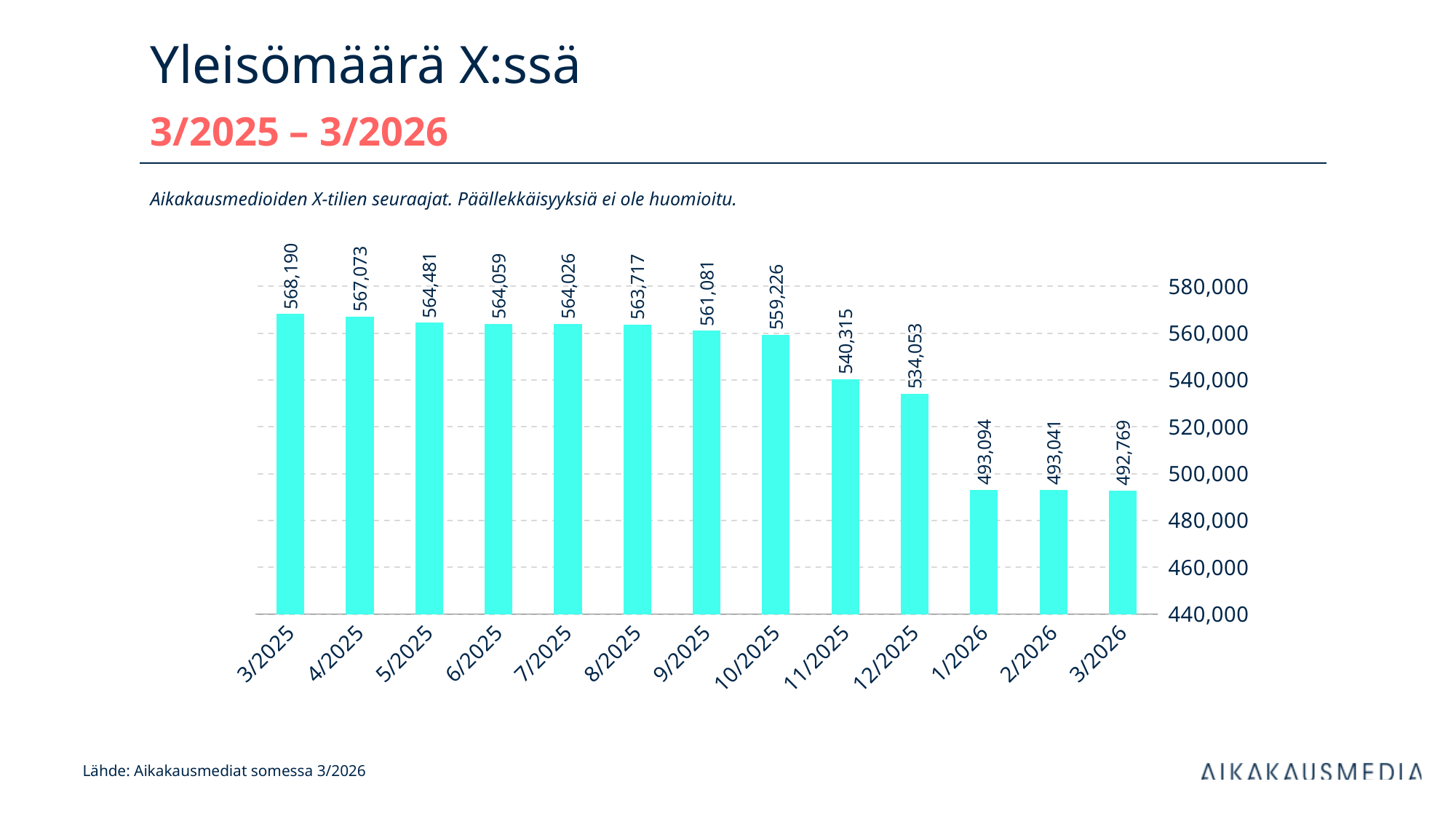
What is the value for 3/2026? 492,769 Do the values rise or fall from 3/2025 to 3/2026? fall How many months are shown on the x axis? 13 What is the difference between the values for 3/2025 and 3/2026? 75,421 What kind of chart is shown on the slide? bar chart Which month has the lowest value? 3/2026 What is the value for 11/2025? 540,315 Which month has the highest value? 3/2025 Is the value for 10/2025 greater or less than 540,000? greater What is the difference between the values for 12/2025 and 1/2026? 40,959 What is the value for 3/2025? 568,190 Which is larger, the value for 9/2025 or the value for 12/2025? 9/2025